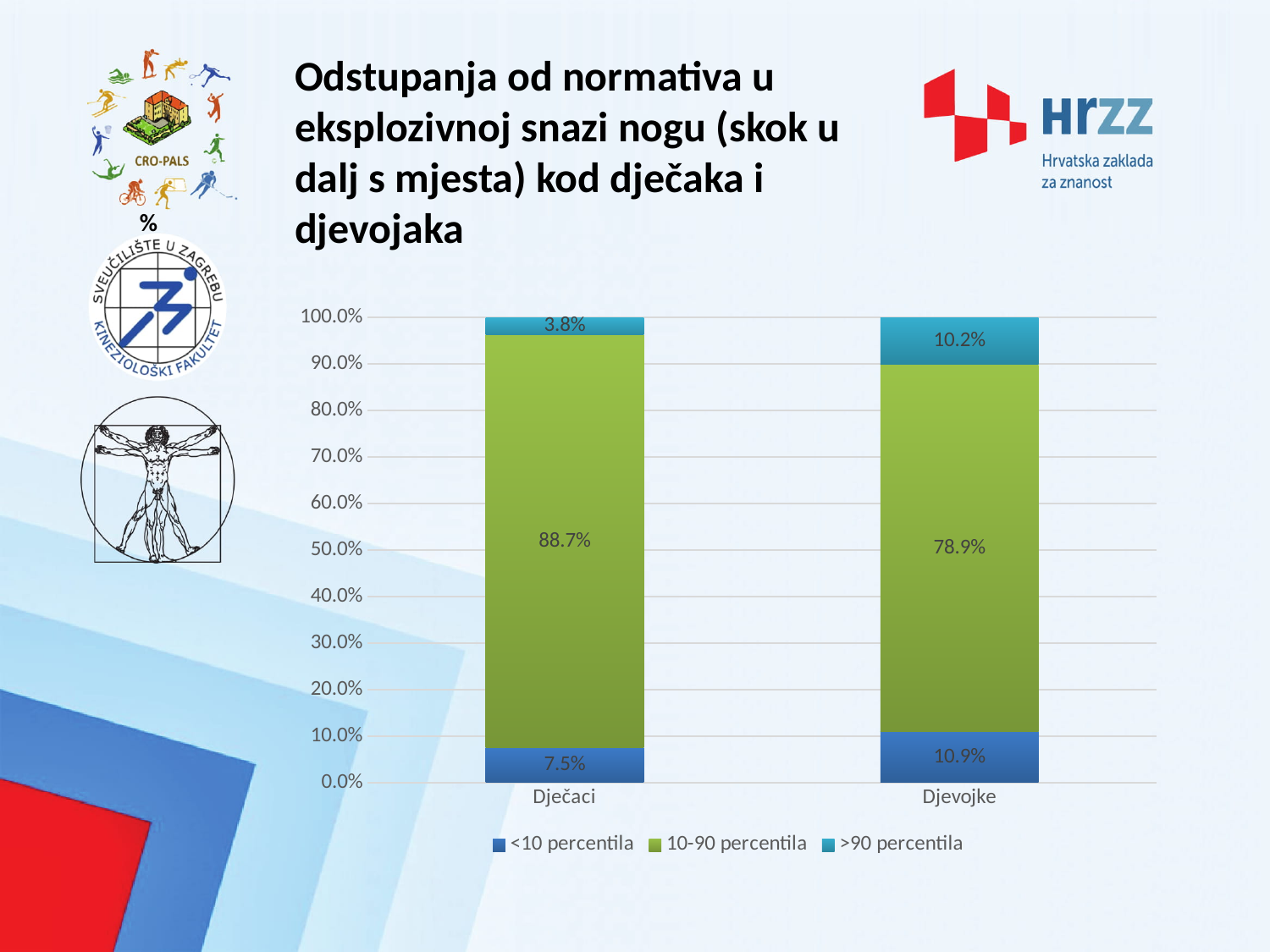
Which colour represents the >90 percentila series? Teal (light blue) What is the difference between the 10-90 percentila values for Dječaci and Djevojke? 9.8% What is the value of the <10 percentila series for Djevojke? 10.9% What kind of chart is shown on the slide? Stacked bar chart How many series does the legend list? 3 What is the difference between the <10 percentila values for Djevojke and Dječaci? 3.4% Which category has the lower value for the >90 percentila series? Dječaci What is the value of the >90 percentila series for Djevojke? 10.2% What is the value of the 10-90 percentila series for Dječaci? 88.7% What is the value of the <10 percentila series for Dječaci? 7.5% How many categories are shown on the x axis? 2 Which category has the higher value for the 10-90 percentila series? Dječaci